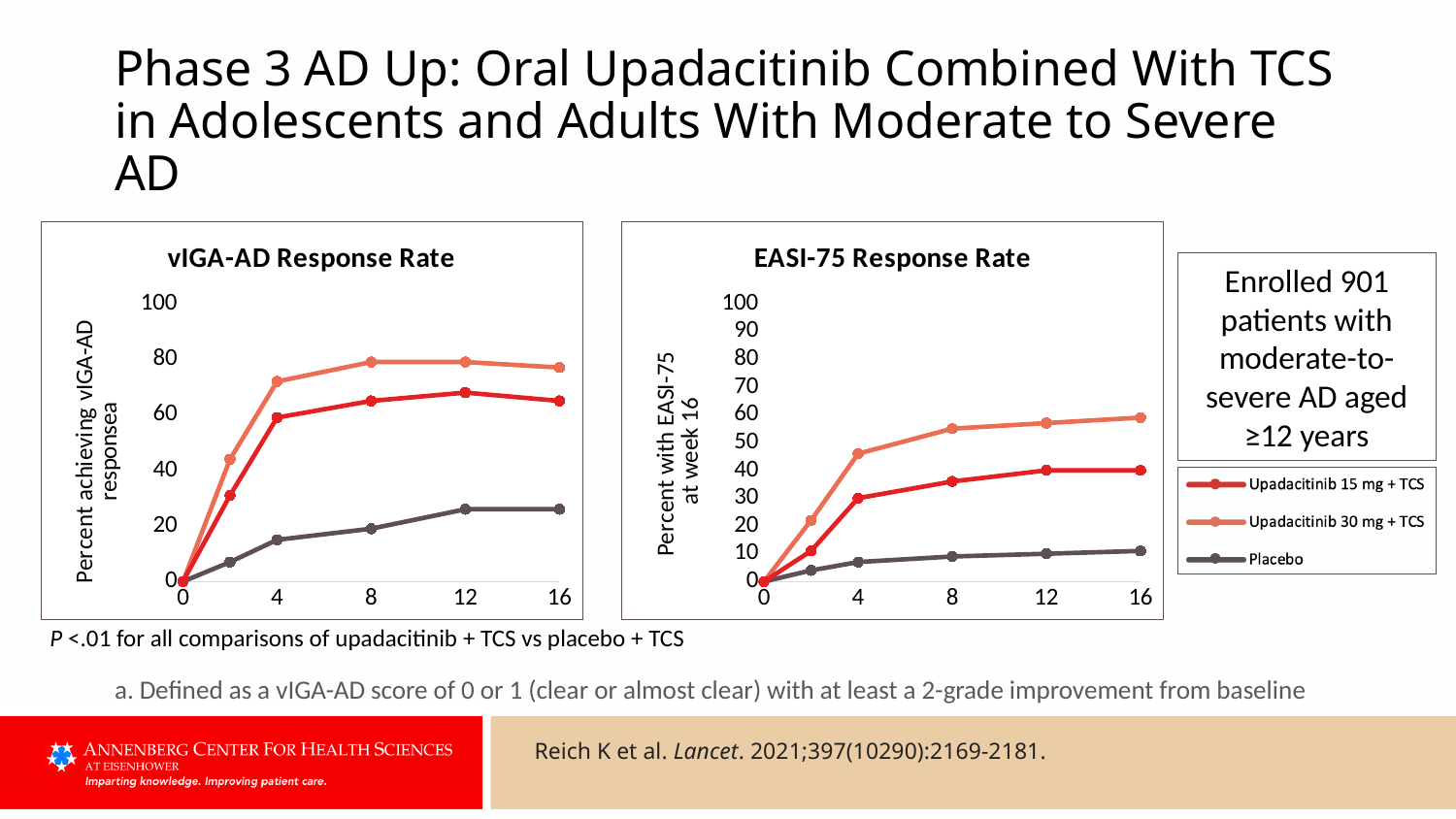
In the vIGA-AD Response Rate chart, is the value for Placebo at week 16 greater or less than 40? less In the EASI-75 Response Rate chart, does the Upadacitinib 30 mg + TCS series rise or fall from week 0 to week 16? rise In the EASI-75 Response Rate chart, which series has the lowest value at week 16? Placebo In the EASI-75 Response Rate chart, how many data points are plotted for the Placebo series? 6 In the vIGA-AD Response Rate chart, which is larger at week 16: Upadacitinib 15 mg + TCS or Placebo? Upadacitinib 15 mg + TCS How many series does the legend list for the charts? 3 In the vIGA-AD Response Rate chart, is the value for Upadacitinib 30 mg + TCS at week 16 greater or less than 60? greater What kind of chart is the vIGA-AD Response Rate chart? Line chart In the EASI-75 Response Rate chart, which is larger at week 4: Upadacitinib 30 mg + TCS or Upadacitinib 15 mg + TCS? Upadacitinib 30 mg + TCS In the EASI-75 Response Rate chart, which series has the highest value at week 16? Upadacitinib 30 mg + TCS What is the title of the chart on the left? vIGA-AD Response Rate In the EASI-75 Response Rate chart, is the value for Upadacitinib 15 mg + TCS at week 16 greater or less than 30? greater